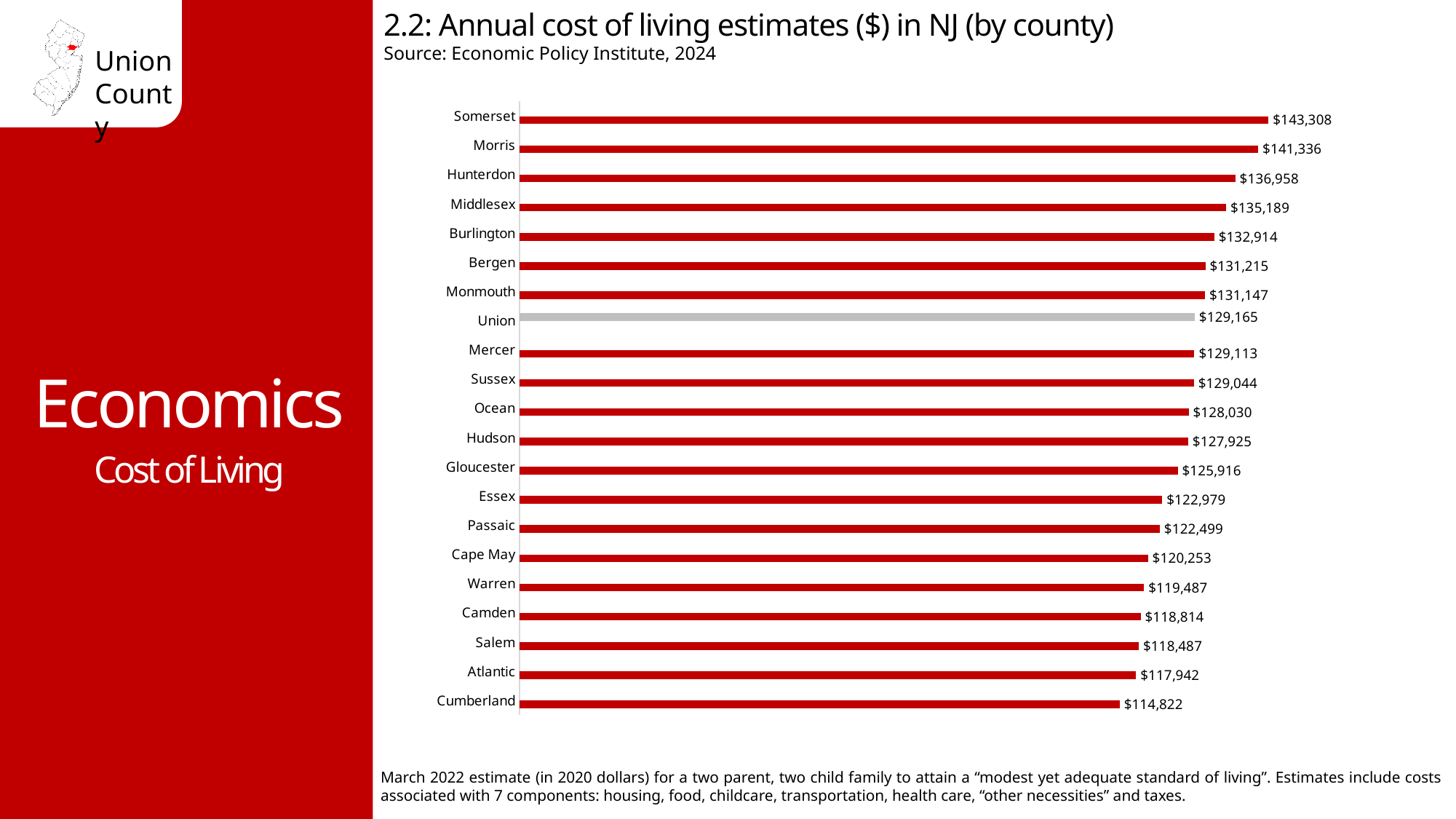
What is the difference between the cost of living estimates for Somerset and Cumberland counties? $28,486 How many counties are shown in the chart? 21 What is the annual cost of living estimate for Cape May County? $120,253 Which county has the highest annual cost of living estimate? Somerset Which county's bar is shown in grey rather than red? Union Which county has a higher cost of living estimate, Bergen or Monmouth? Bergen What is the annual cost of living estimate for Hunterdon County? $136,958 Which county has a higher cost of living estimate, Essex or Gloucester? Gloucester Which county has the lowest annual cost of living estimate? Cumberland What type of chart is used to show the annual cost of living estimates? Bar chart What is the difference between the cost of living estimates for Morris and Union counties? $12,171 What is the annual cost of living estimate for Union County? $129,165